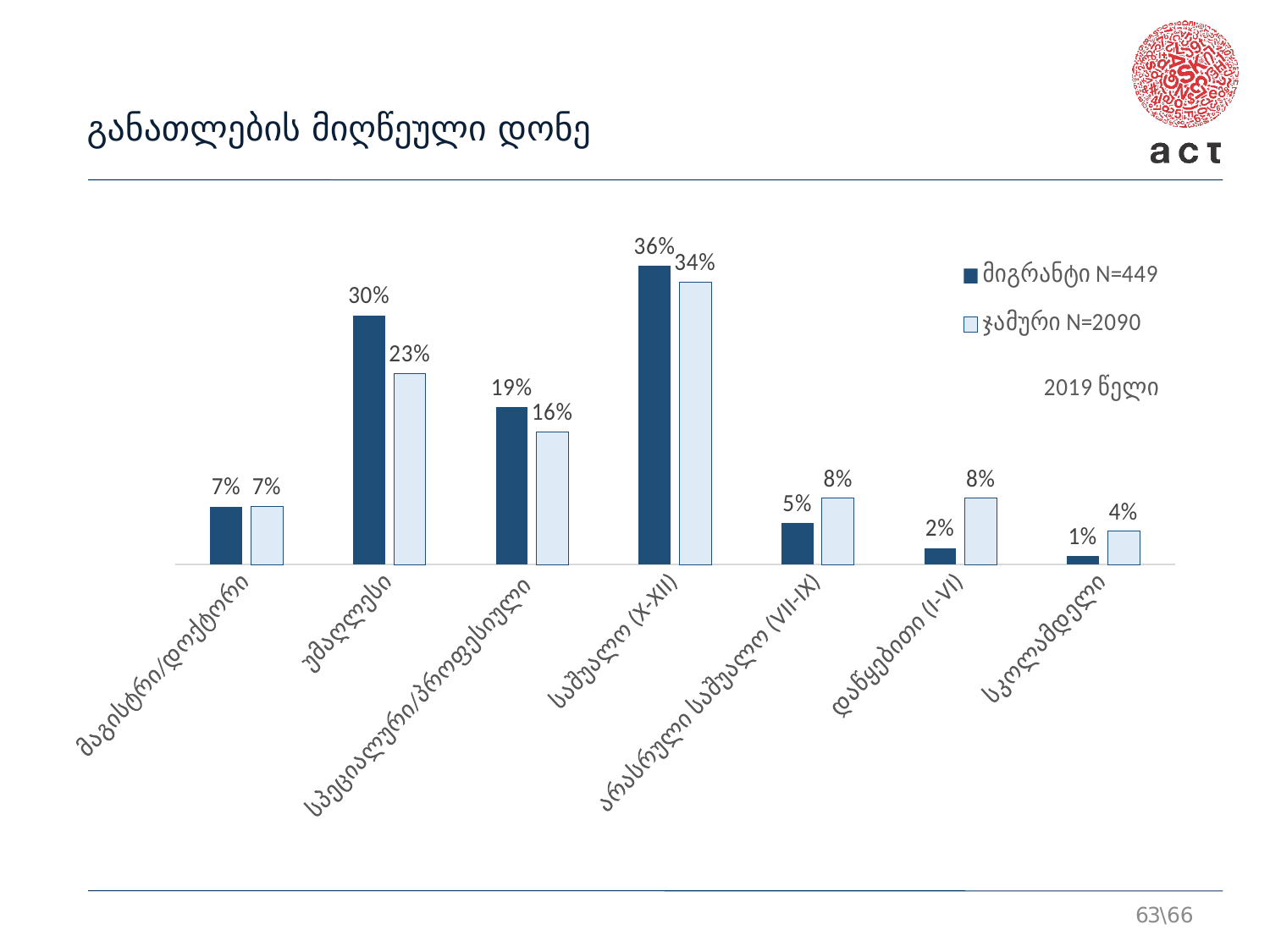
What type of chart is shown on the slide? bar chart What is the value for დაწყებითი (I-VI) in the მიგრანტი N=449 series? 2% What is the value for სპეციალური/პროფესიული in the ჯამური N=2090 series? 16% Which category has the lowest value in the მიგრანტი N=449 series? სკოლამდელი What is the difference between the მიგრანტი N=449 and ჯამური N=2090 values for უმაღლესი? 7% Which category has the highest value in the მიგრანტი N=449 series? საშუალო (X-XII) How many categories are shown on the x axis? 7 How many series does the legend list? 2 What is the value for უმაღლესი in the მიგრანტი N=449 series? 30% For არასრული საშუალო (VII-IX), which series has the larger value, მიგრანტი N=449 or ჯამური N=2090? ჯამური N=2090 What is the value for საშუალო (X-XII) in the ჯამური N=2090 series? 34% What year is indicated next to the legend? 2019 წელი